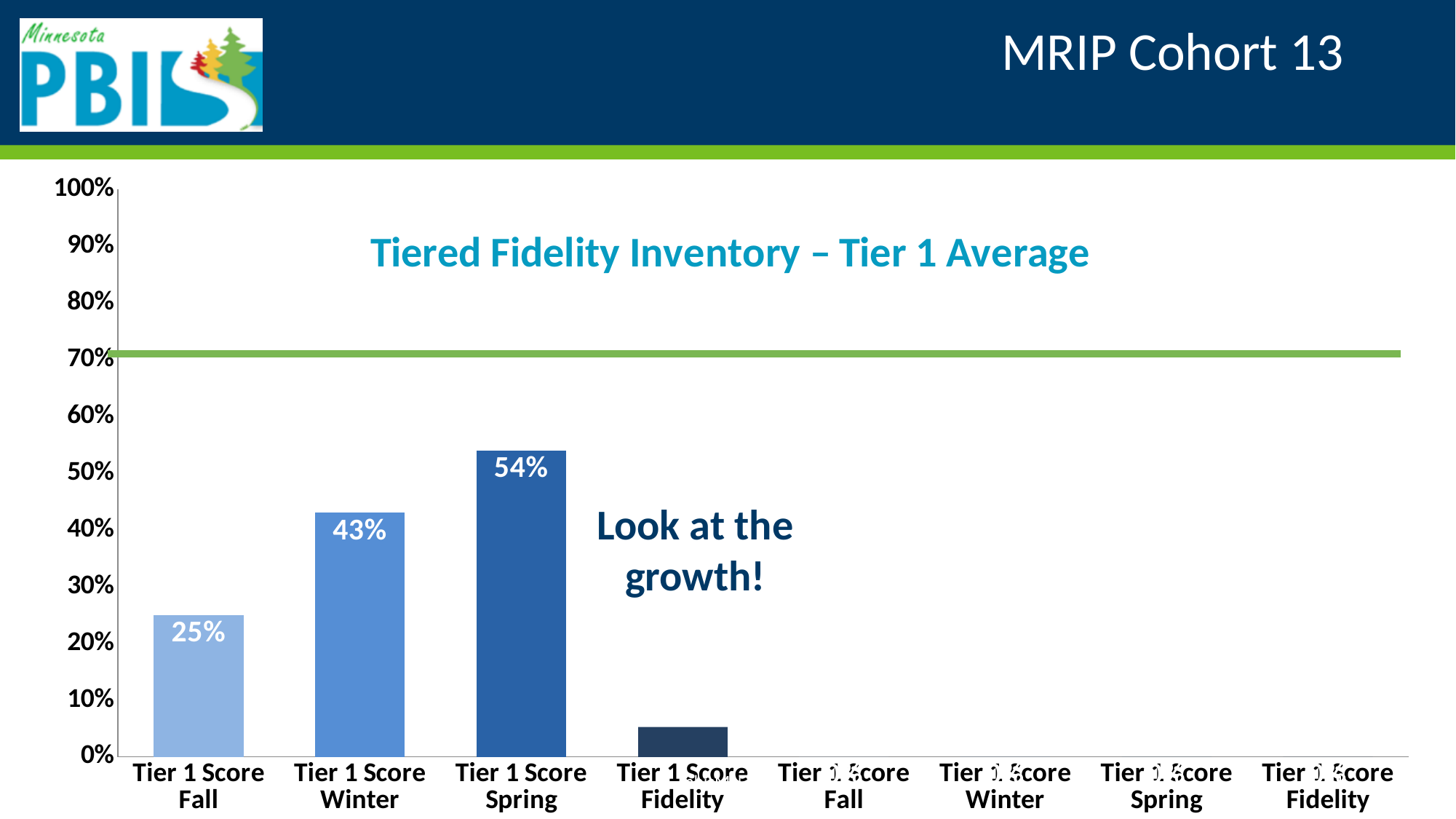
What kind of chart is shown on the slide? bar chart What is the value for Tier 1 Score Fall? 25% Which of the labelled bars has the lowest value? Tier 1 Score Fall What is the value for Tier 1 Score Winter? 43% What is the title of the chart? Tiered Fidelity Inventory – Tier 1 Average Which of the labelled bars has the highest value? Tier 1 Score Spring What is the difference between the Tier 1 Score Spring and Tier 1 Score Fall values? 29% Which is larger, the Tier 1 Score Winter value or the Tier 1 Score Spring value? Tier 1 Score Spring Do the values rise or fall from Tier 1 Score Fall to Tier 1 Score Spring? rise What is the difference between the Tier 1 Score Winter and Tier 1 Score Fall values? 18% Is the value for Tier 1 Score Fidelity greater or less than 10%? less What is the value for Tier 1 Score Spring? 54%